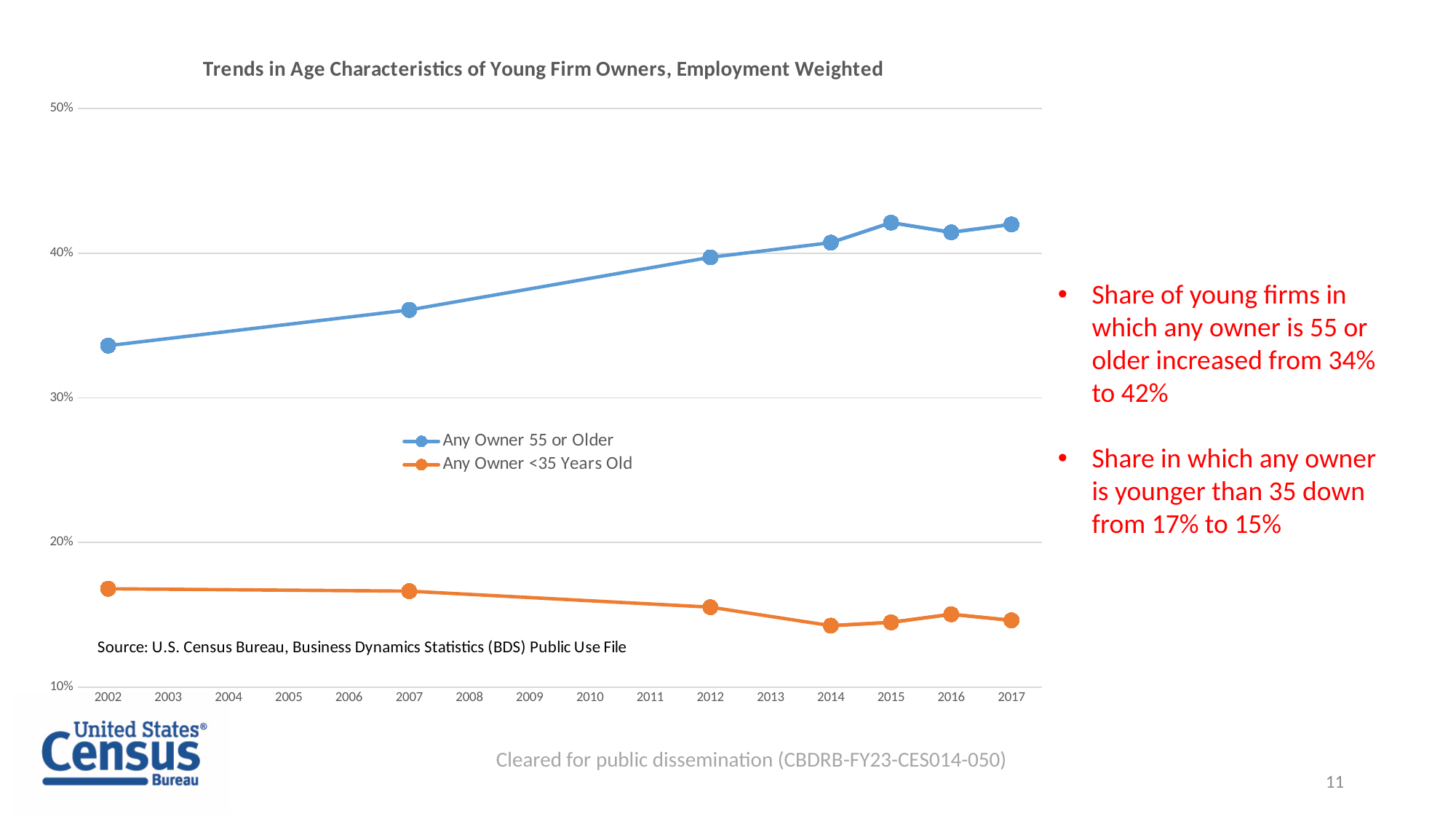
Is the value for 'Any Owner 55 or Older' in 2002 greater or less than 30%? greater Does the 'Any Owner <35 Years Old' series generally rise or fall from 2002 to 2017? Fall What kind of chart is shown on the slide? Line chart Is the value for 'Any Owner 55 or Older' in 2015 greater or less than 40%? greater How many series does the chart's legend list? 2 Is the value for 'Any Owner <35 Years Old' in 2002 greater or less than 20%? less How many data points are plotted for the 'Any Owner 55 or Older' series? 7 Does the 'Any Owner 55 or Older' series generally rise or fall from 2002 to 2017? Rise In which year is the 'Any Owner 55 or Older' series at its lowest? 2002 Which series is drawn in orange in the chart? Any Owner <35 Years Old In 2012, which series has the larger value: 'Any Owner 55 or Older' or 'Any Owner <35 Years Old'? Any Owner 55 or Older What is the title of the chart? Trends in Age Characteristics of Young Firm Owners, Employment Weighted